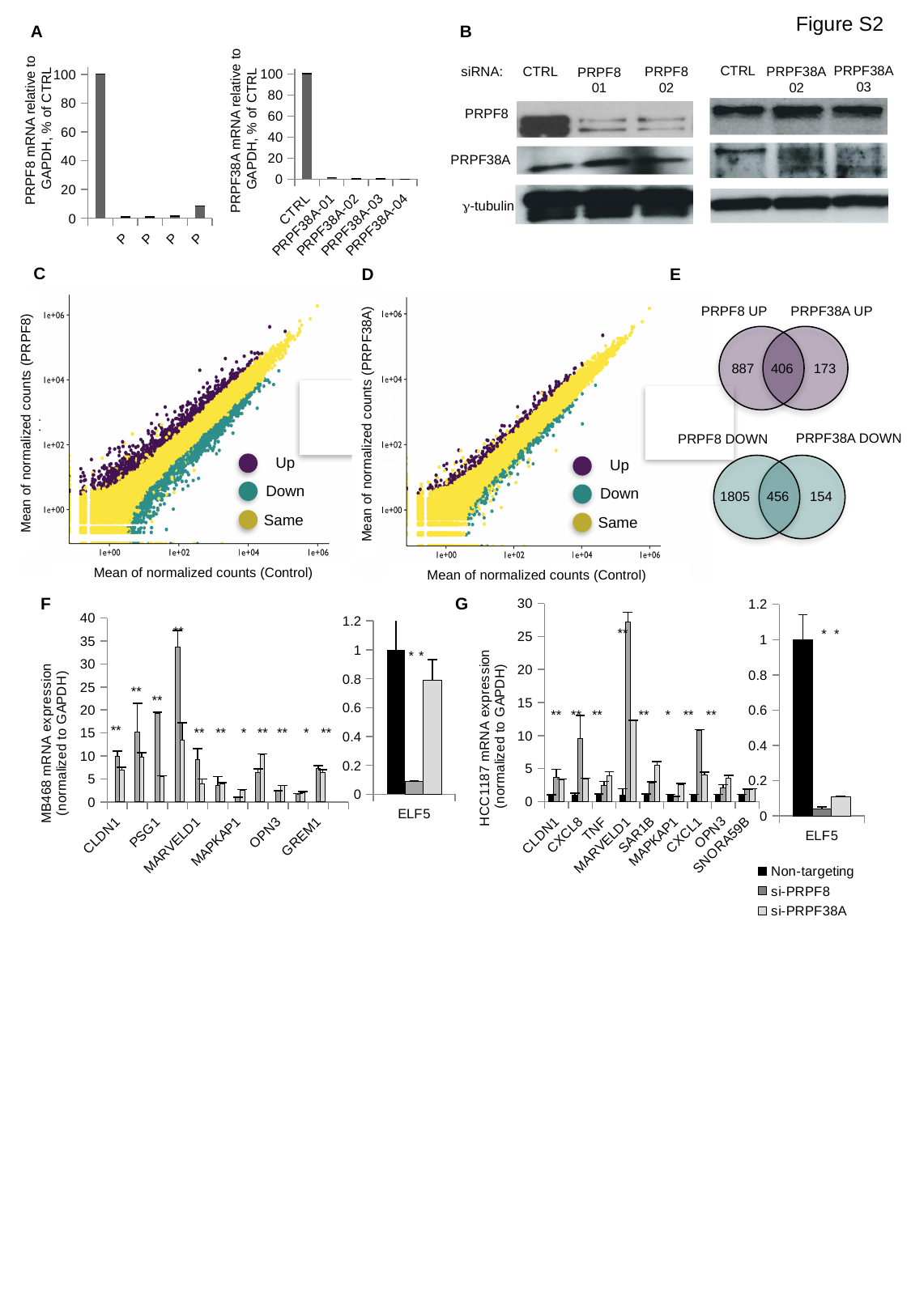
In the right-hand bar chart of panel A (PRPF38A mRNA relative to GAPDH), what is the value for CTRL? 100 In the right-hand bar chart of panel A (PRPF38A mRNA relative to GAPDH), which category has the highest value? CTRL In the MB468 mRNA expression bar chart of panel F, how many genes are listed on the x axis? 6 In the Venn diagram of panel E, how many genes are in PRPF8 DOWN only (not shared with PRPF38A DOWN)? 1805 How many series does the legend below panel G list? 3 In the Venn diagram of panel E, what is the difference between the PRPF8 DOWN-only count and the PRPF38A DOWN-only count? 1651 In the Venn diagram of panel E, how many genes are in the overlap of PRPF8 UP and PRPF38A UP? 406 What kind of chart is panel C (Mean of normalized counts PRPF8 vs Control)? scatter plot In the HCC1187 mRNA expression bar chart of panel G, is the si-PRPF8 value for MARVELD1 greater or less than 20? greater How many entries does the legend of panel D list? 3 In the right-hand bar chart of panel A (PRPF38A mRNA relative to GAPDH), how many categories are shown on the x axis? 5 In the Venn diagram of panel E, which is larger: the PRPF8 UP-only count or the PRPF38A UP-only count? PRPF8 UP-only